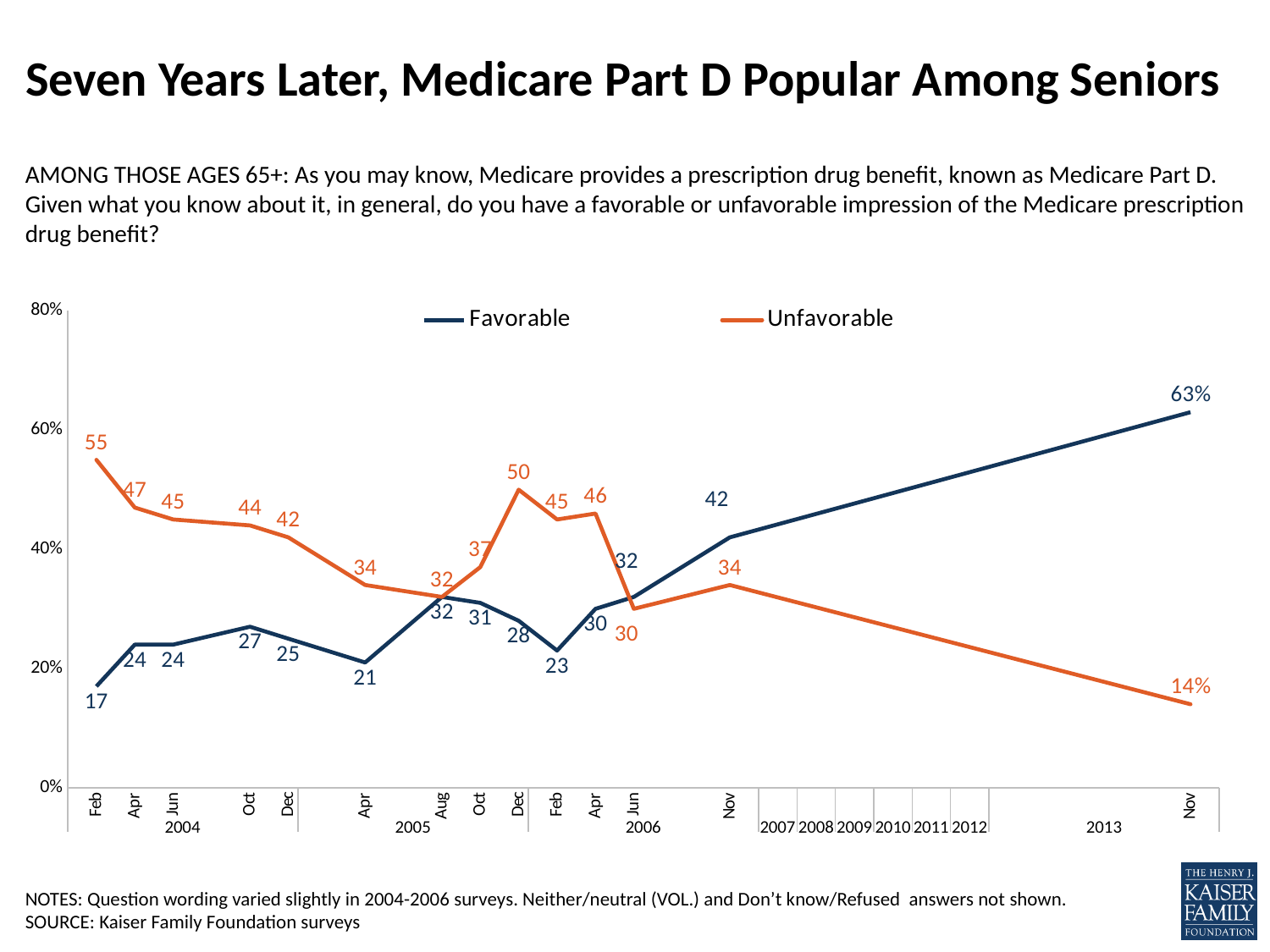
Does the Unfavorable series rise or fall between Nov 2006 and Nov 2013? Fall Is the Favorable value for Nov 2013 greater or less than 60%? greater In Nov 2013, how many percentage points higher is Favorable than Unfavorable? 49 What is the Unfavorable value for Feb 2004? 55 In Dec 2005, which is larger, Favorable or Unfavorable? Unfavorable What are the two series named in the legend? Favorable and Unfavorable At which survey date is the Favorable series lowest? Feb 2004 What is the Favorable value for Nov 2006? 42 How many series does the legend list? 2 At which survey date is the Unfavorable series highest? Feb 2004 What is the Favorable value for Nov 2013? 63% What kind of chart is shown on the slide? Line chart